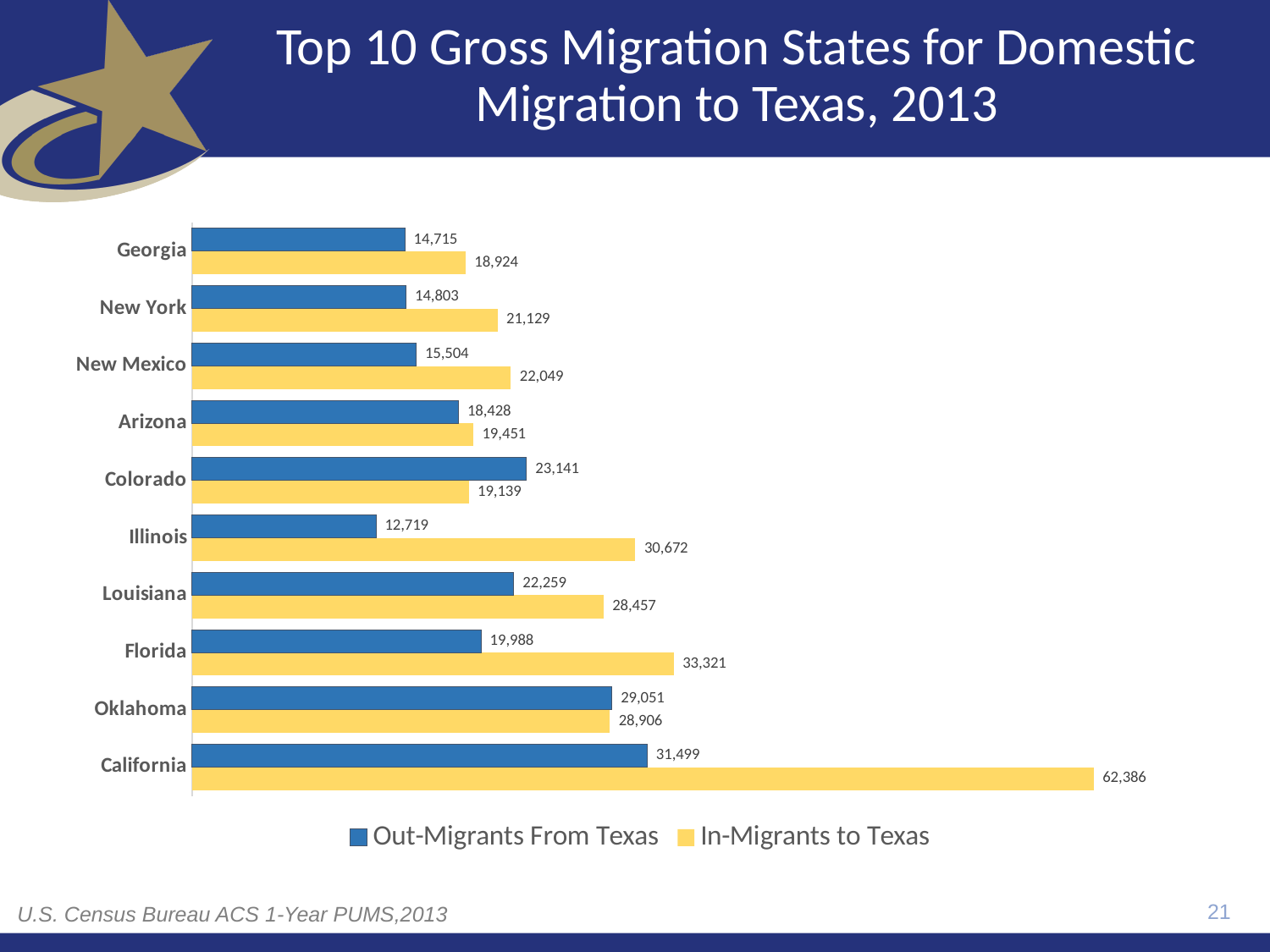
Which state has the lowest number of Out-Migrants From Texas? Illinois What is the difference between In-Migrants to Texas and Out-Migrants From Texas for Florida? 13,333 How many states are shown on the chart? 10 Which colour represents In-Migrants to Texas in the legend? Yellow Which state has the highest number of In-Migrants to Texas? California What is the difference between In-Migrants to Texas and Out-Migrants From Texas for Illinois? 17,953 What is the number of Out-Migrants From Texas to Illinois? 12,719 What is the number of In-Migrants to Texas from California? 62,386 How many series does the legend list? 2 What kind of chart is shown on the slide? Bar chart What is the number of In-Migrants to Texas from Louisiana? 28,457 For Colorado, which is larger: Out-Migrants From Texas or In-Migrants to Texas? Out-Migrants From Texas